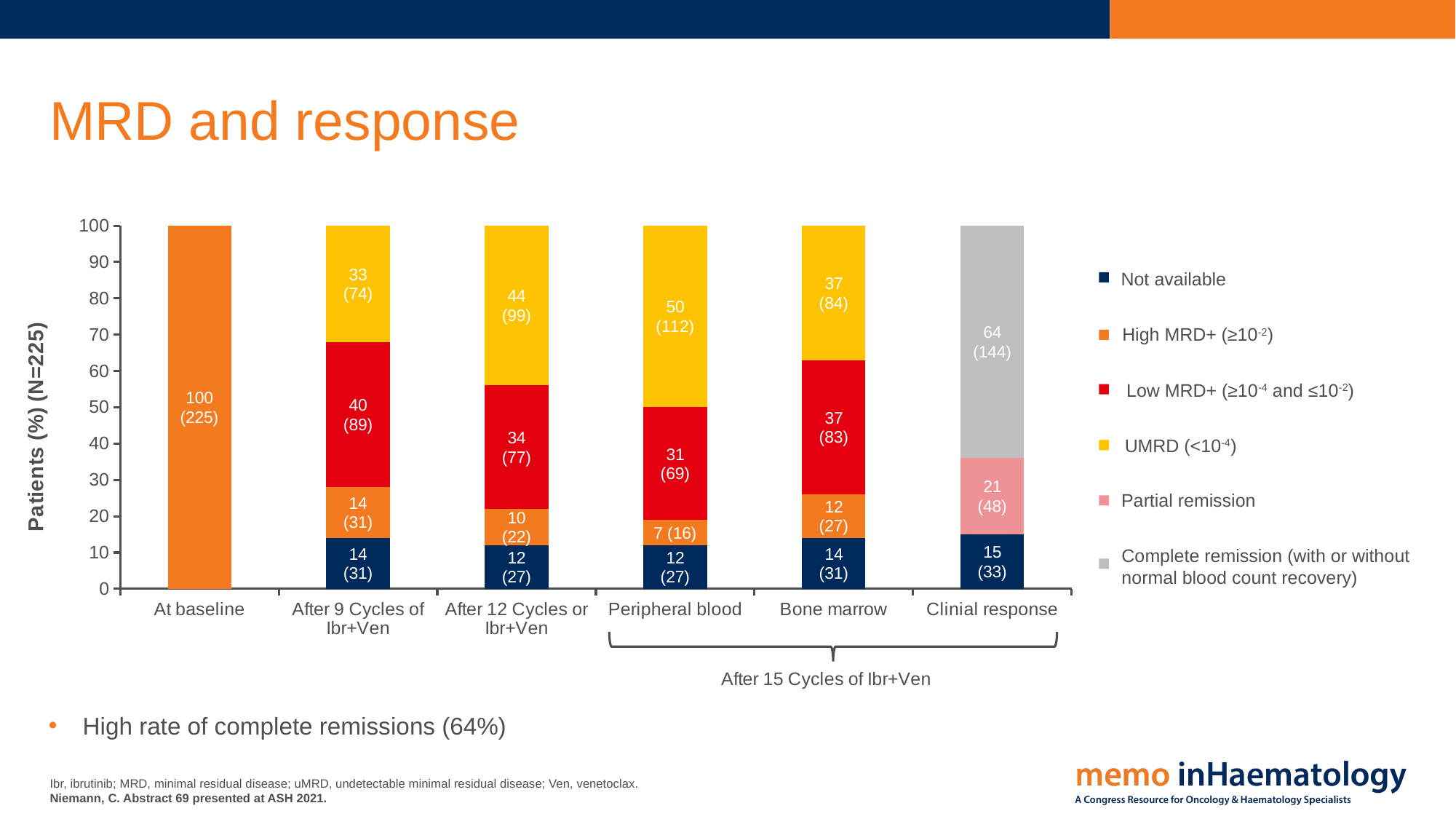
What is the UMRD (<10-4) value labelled for the 'After 9 Cycles of Ibr+Ven' bar? 33 (74) By how many percentage points does the UMRD value after 12 cycles (44) exceed the UMRD value after 9 cycles (33)? 11 What is the Complete remission value labelled in the 'Clinial response' bar? 64 (144) How many series does the chart legend list? 6 What is the Partial remission value labelled in the 'Clinial response' bar? 21 (48) What is the Low MRD+ value labelled for the 'Bone marrow' bar? 37 (83) Which has the larger Low MRD+ percentage: 'After 9 Cycles of Ibr+Ven' or 'After 12 Cycles or Ibr+Ven'? After 9 Cycles of Ibr+Ven Which category has the smallest High MRD+ segment? Peripheral blood What is the title of the y axis? Patients (%) (N=225) Which category has the largest UMRD (<10-4) segment? Peripheral blood How many categories are shown along the x axis of the chart? 6 What type of chart is shown on the slide? Stacked bar chart